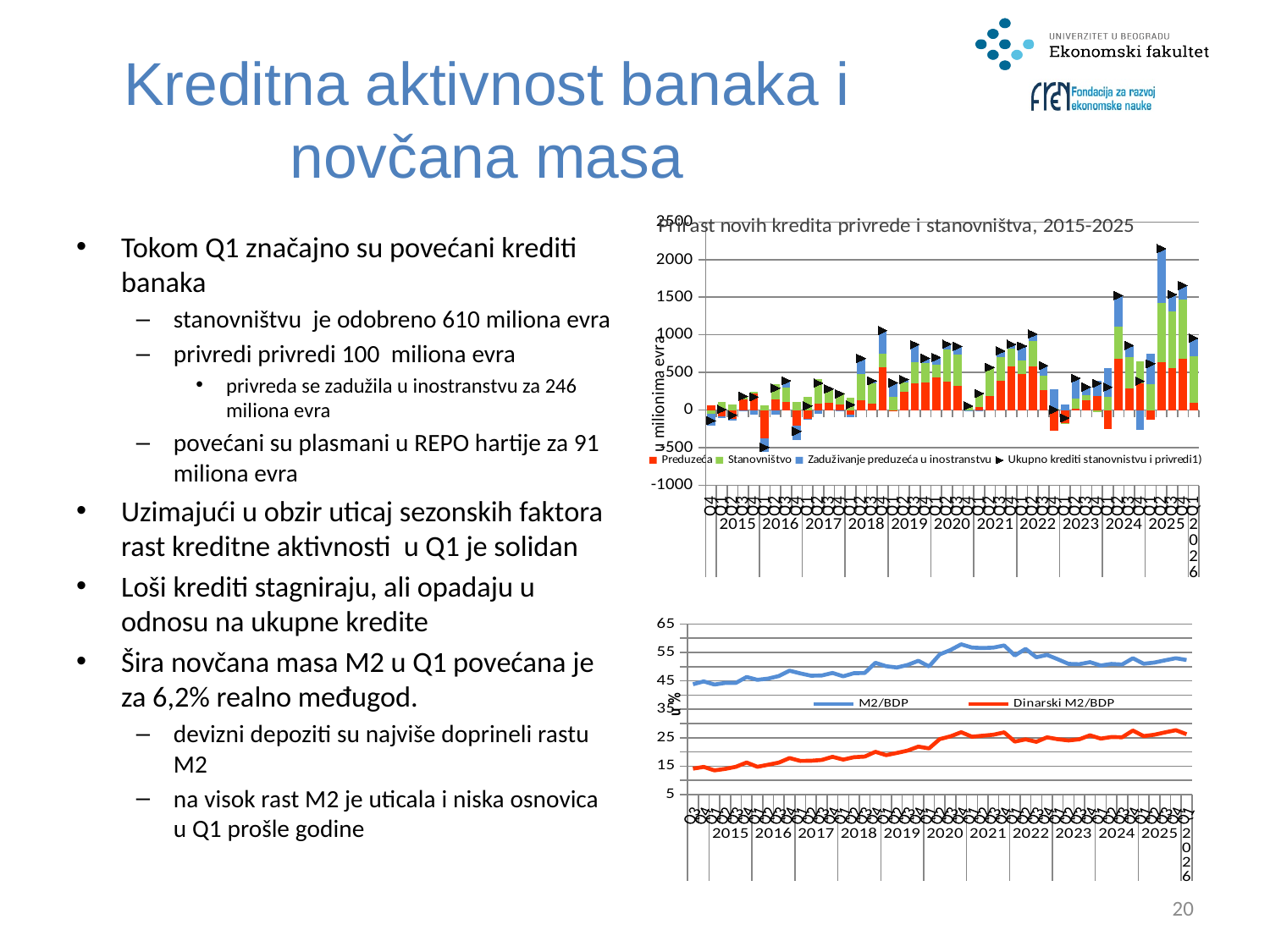
What is the y-axis label of the top chart? u milionima evra In the bottom chart, is the value of M2/BDP at the start of 2015 greater or less than 55? less What type of chart is the top chart on the slide? bar chart In the top chart, is the highest total credit marker (Ukupno krediti stanovnistvu i privredi) greater or less than 2000? greater What is the title of the top chart? Prirast novih kredita privrede i stanovništva, 2015-2025 What type of chart is the bottom chart on the slide? line chart In the bottom chart, is the highest value of the M2/BDP line greater or less than 55? greater How many series does the legend of the top chart list? 4 How many series does the legend of the bottom chart list? 2 In the bottom chart, does the Dinarski M2/BDP line generally rise or fall from 2015 to 2025? rise In the bottom chart, which series has higher values throughout the period, M2/BDP or Dinarski M2/BDP? M2/BDP